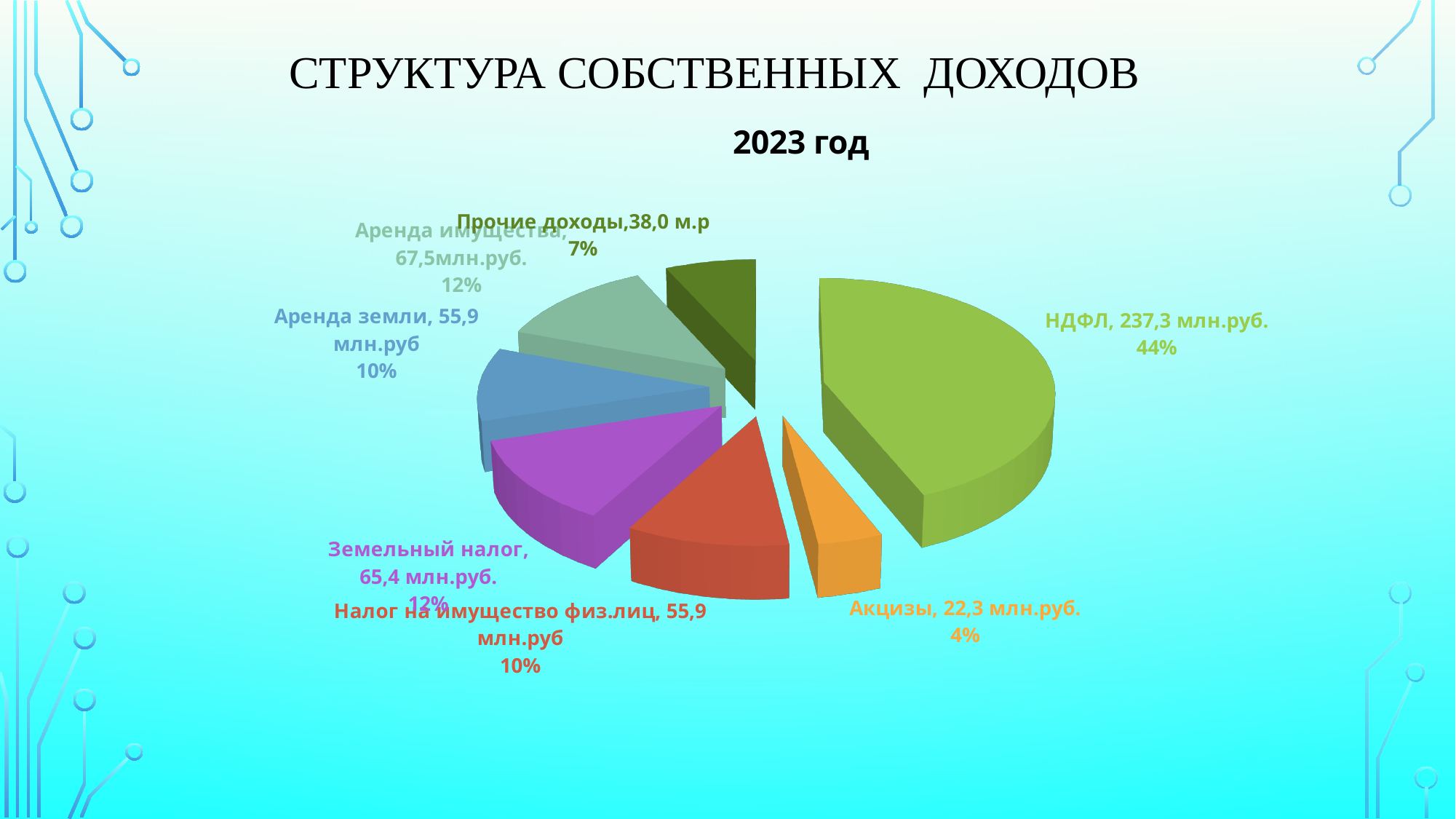
Which is larger, the value for Прочие доходы or the value for Аренда земли? Аренда земли What kind of chart is shown on the slide? pie chart What is the value for Акцизы? 22,3 млн.руб. What is the value for НДФЛ? 237,3 млн.руб. What is the title shown above the chart? 2023 год What is the value for Земельный налог? 65,4 млн.руб. What share of the pie does Акцизы represent? 4% Which category has the largest slice? НДФЛ What is the difference between the values for Аренда имущества and Земельный налог? 2,1 млн.руб. What share of the pie does НДФЛ represent? 44% Which category has the smallest slice? Акцизы How many slices does the pie chart have? 7